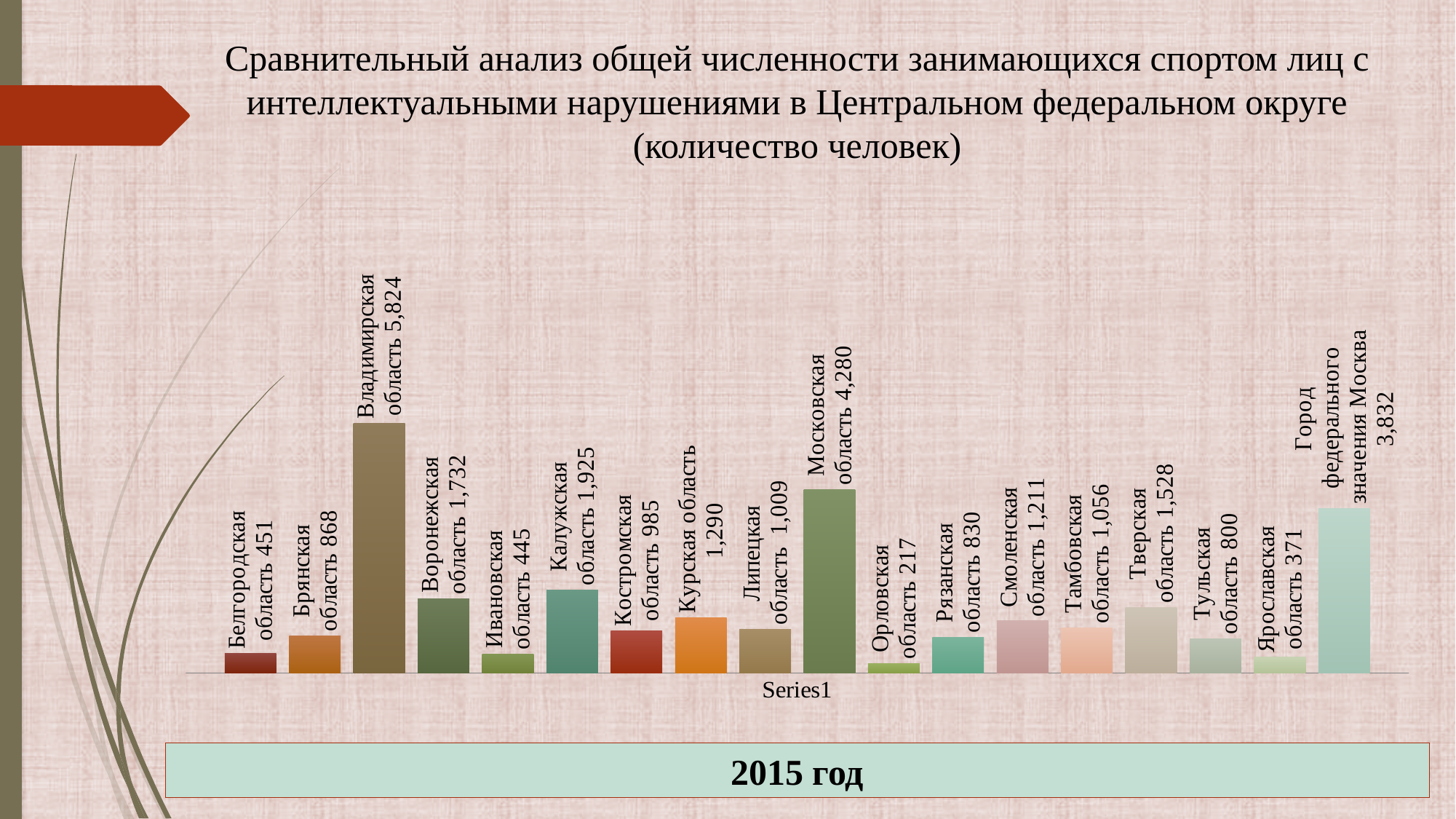
What type of chart is shown on the slide? bar chart Which region has the lowest value? Орловская область Which region has the highest value? Владимирская область What is the value for Тверская область? 1,528 Which is larger, the value for Курская область or the value for Смоленская область? Курская область What is the value for Город федерального значения Москва? 3,832 What is the value for Владимирская область? 5,824 What is the difference between the values for Калужская область and Воронежская область? 193 How many regions are shown in the chart? 18 What is the difference between the values for Московская область and Город федерального значения Москва? 448 What year is indicated in the box below the chart? 2015 год What is the value for Ивановская область? 445